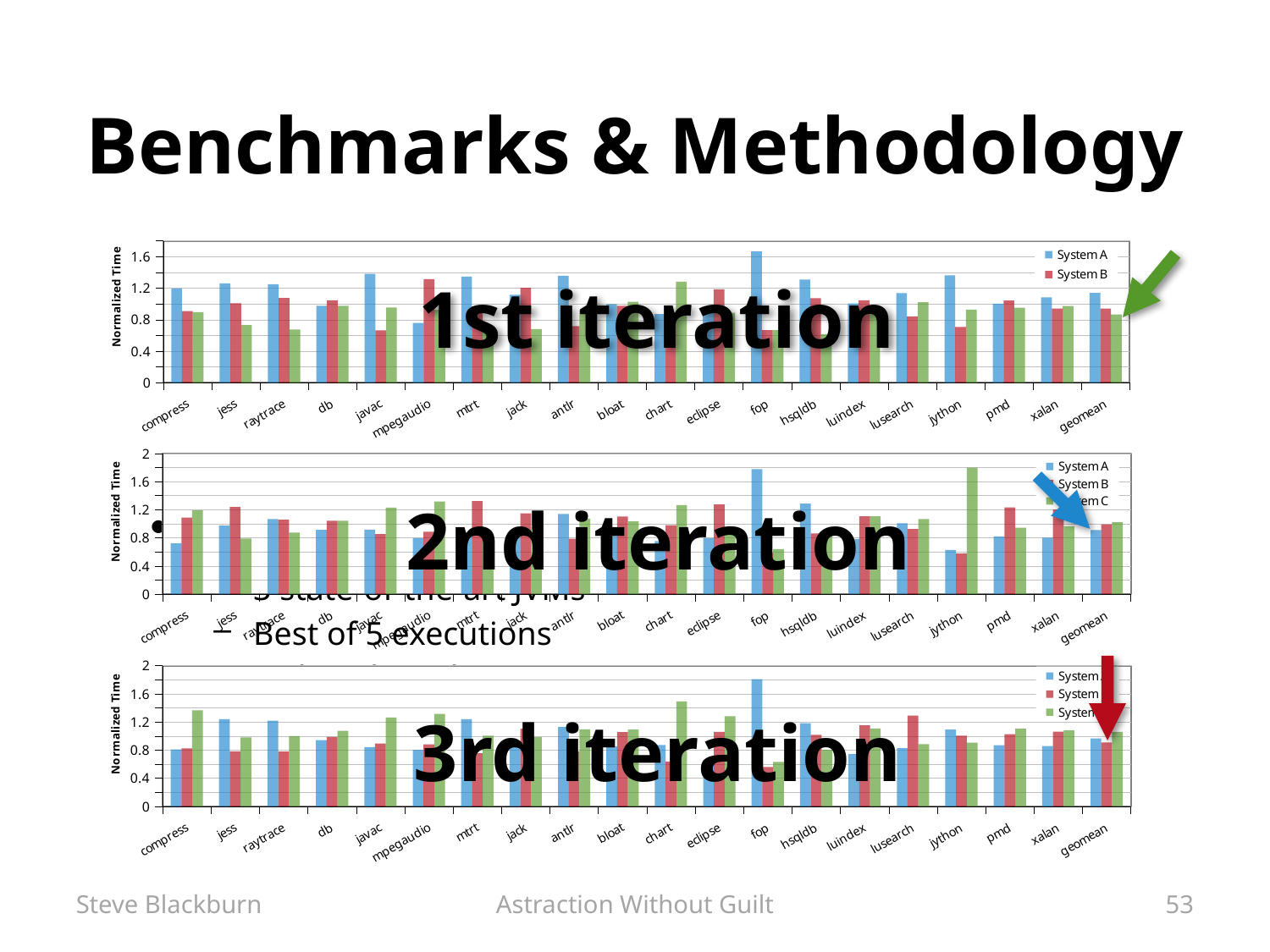
In the '1st iteration' chart, which is larger for compress: System A or System B? System A In the '1st iteration' chart, which category has the tallest System A bar? fop In the '3rd iteration' chart, is the System A value for fop greater or less than 1.6? greater What kind of chart is the '1st iteration' chart? bar chart In the '1st iteration' chart, is the System B value for javac greater or less than 0.8? less In the '2nd iteration' chart, is the System C value for jython greater or less than 1.6? greater How many benchmark categories are shown along the x axis of the '3rd iteration' chart? 20 What is the y-axis label of the '2nd iteration' chart? Normalized Time In the '2nd iteration' chart, which category has the tallest System C bar? jython In the '2nd iteration' chart, how many series does the legend list? 3 In the '3rd iteration' chart, which category has the tallest System A bar? fop